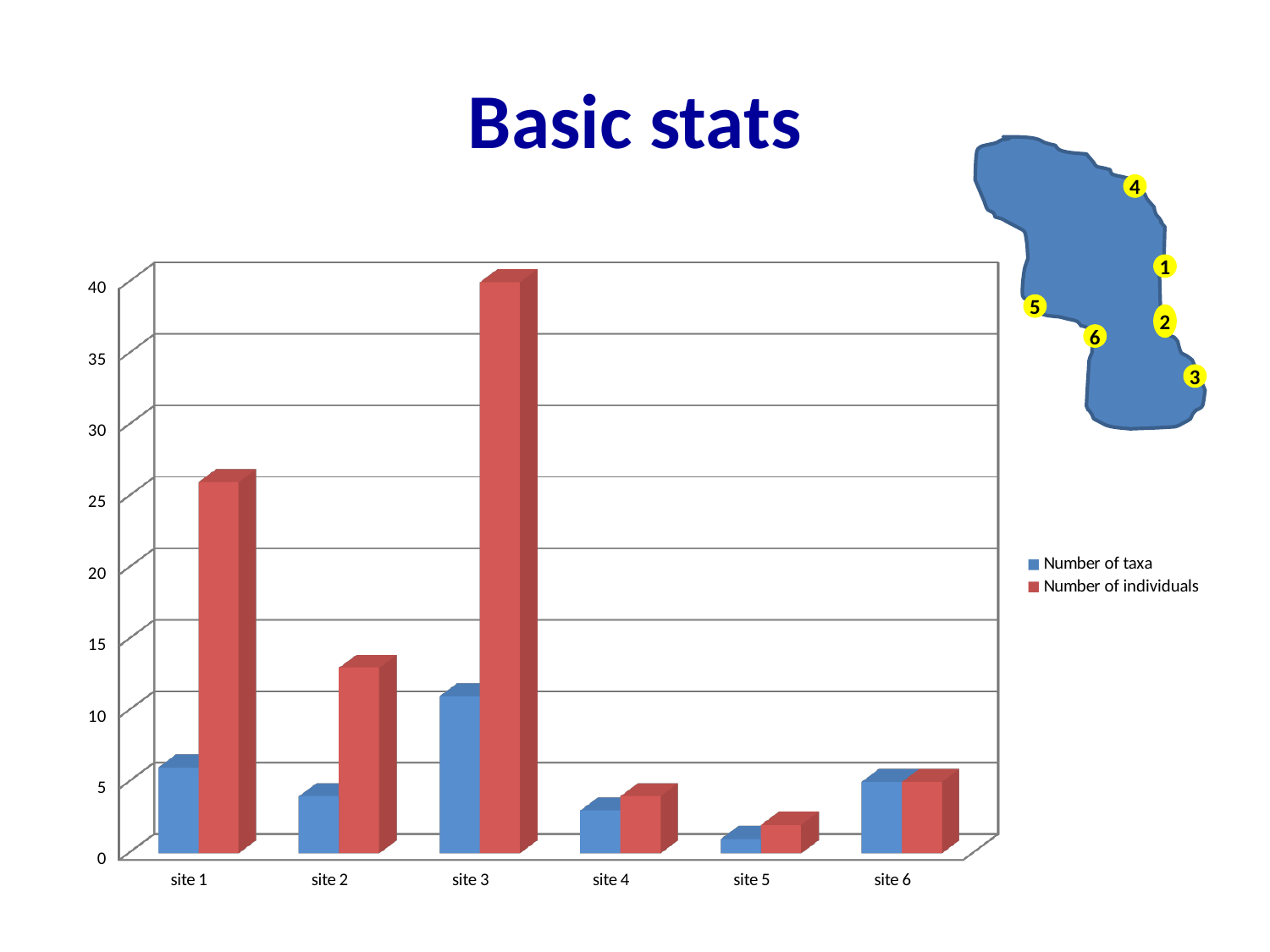
Which site has the lowest Number of individuals? site 5 Which site has a larger Number of individuals, site 1 or site 2? site 1 What kind of chart is shown on the slide? bar chart Is the Number of individuals at site 3 greater or less than 35? greater Is the Number of individuals at site 5 greater or less than 5? less How many series does the chart's legend list? 2 Which site has the highest Number of taxa? site 3 How many sites are shown on the x axis of the chart? 6 Is the Number of individuals at site 1 greater or less than 20? greater Which site has the highest Number of individuals? site 3 What is the title of the slide containing the chart? Basic stats Which site has the lowest Number of taxa? site 5